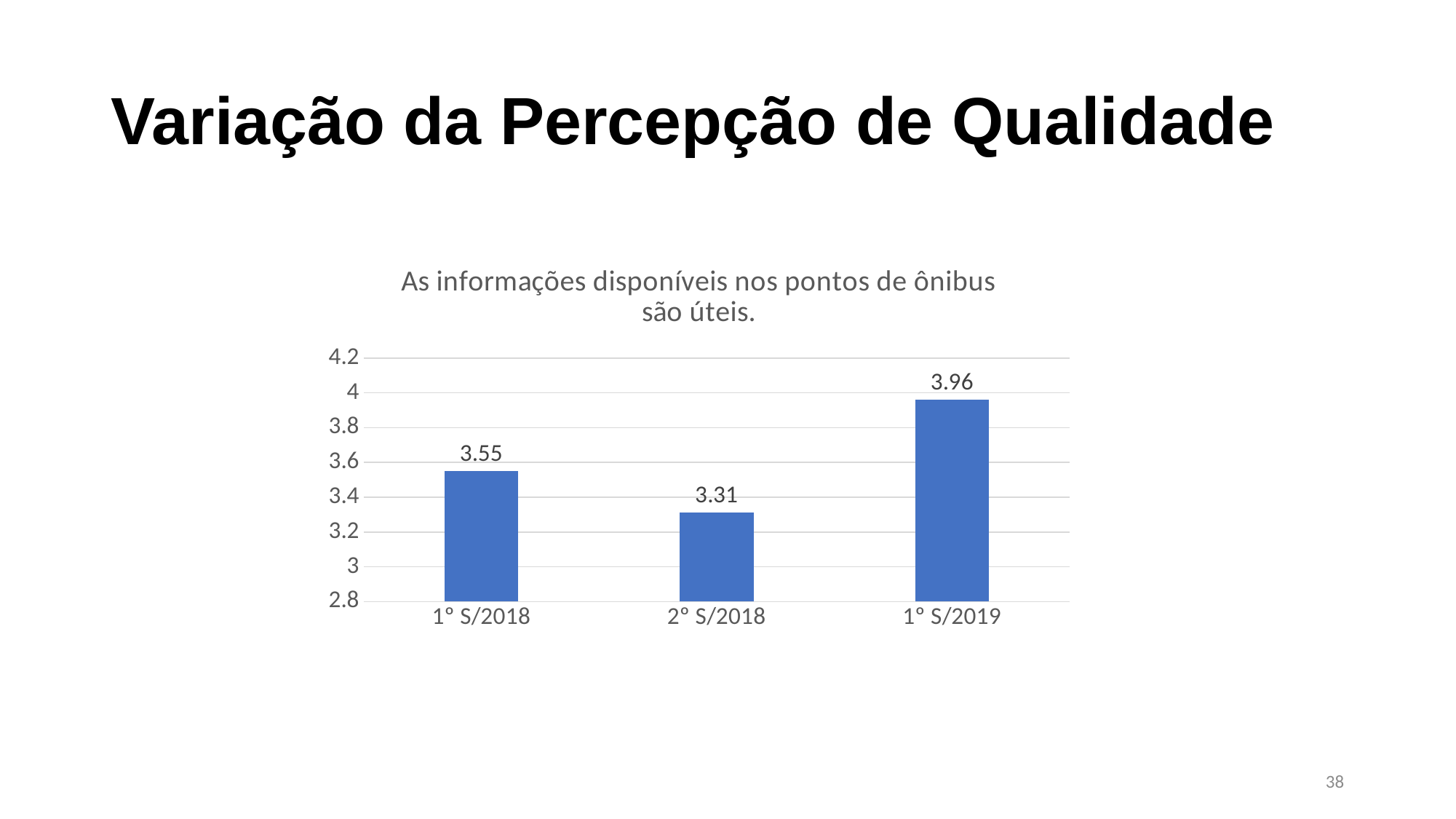
What is the title of the chart? As informações disponíveis nos pontos de ônibus são úteis. What is the value for 1° S/2019? 3.96 What kind of chart is shown on the slide? bar chart What is the value for 1° S/2018? 3.55 What is the difference between the values for 1° S/2018 and 2° S/2018? 0.24 Which period has the highest value? 1° S/2019 Which period has the lowest value? 2° S/2018 How many periods are shown on the x axis? 3 Which is larger, the value for 1° S/2018 or the value for 1° S/2019? 1° S/2019 What is the value for 2° S/2018? 3.31 What is the difference between the values for 1° S/2019 and 2° S/2018? 0.65 Is the value for 1° S/2019 greater or less than 3.8? greater